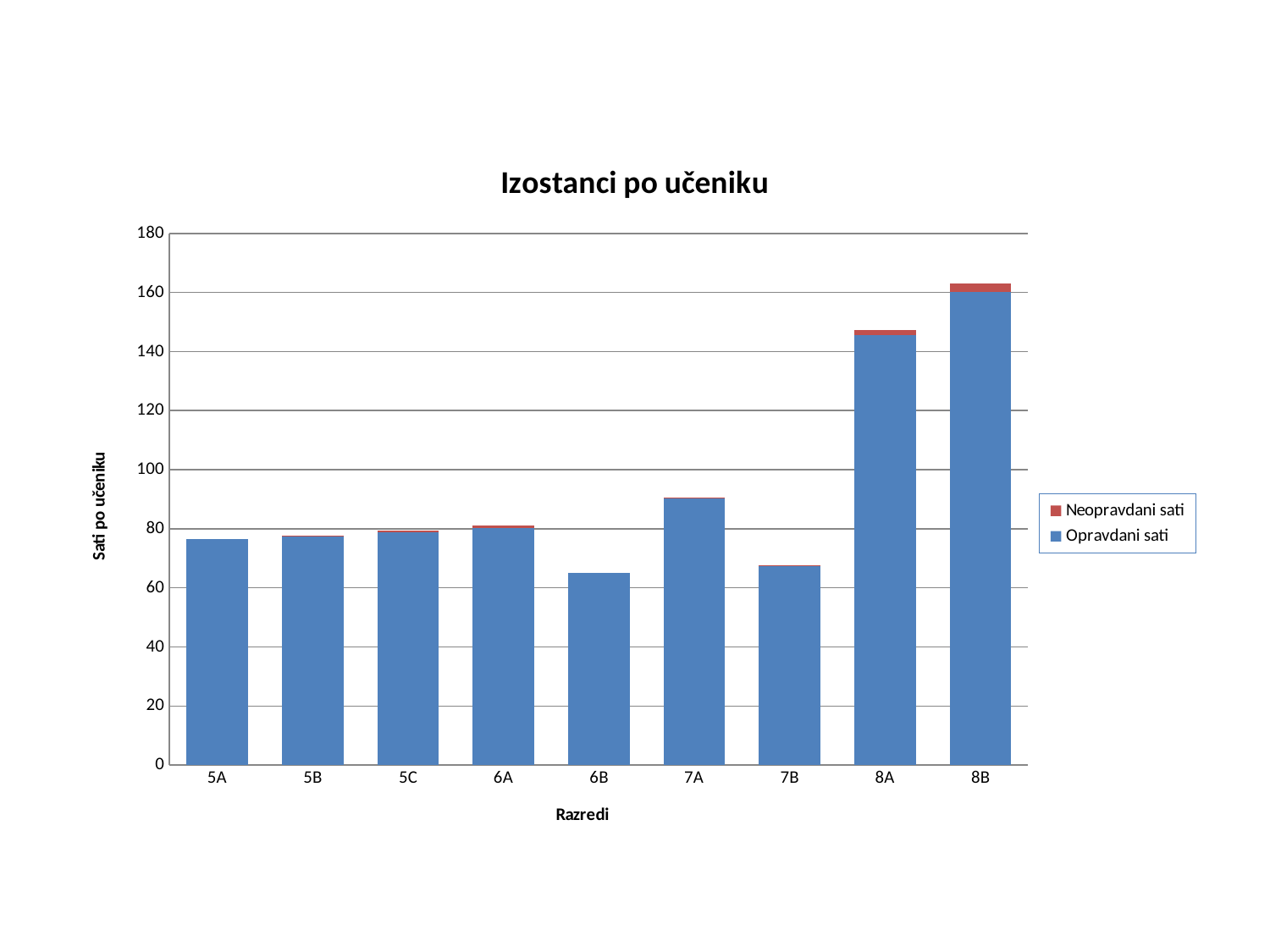
Is the total bar for 5A greater or less than 80? less What is the title of the chart? Izostanci po učeniku How many classes (categories) are shown on the x axis? 9 How many series does the legend list? 2 What type of chart is shown on the slide? bar chart Which class has the highest total bar? 8B Is the total bar for 6B greater or less than 80? less Is the total bar for 7A greater or less than 80? greater Which has the larger total bar, 8A or 8B? 8B What is the label of the x axis? Razredi Which has the larger total bar, 6A or 7A? 7A